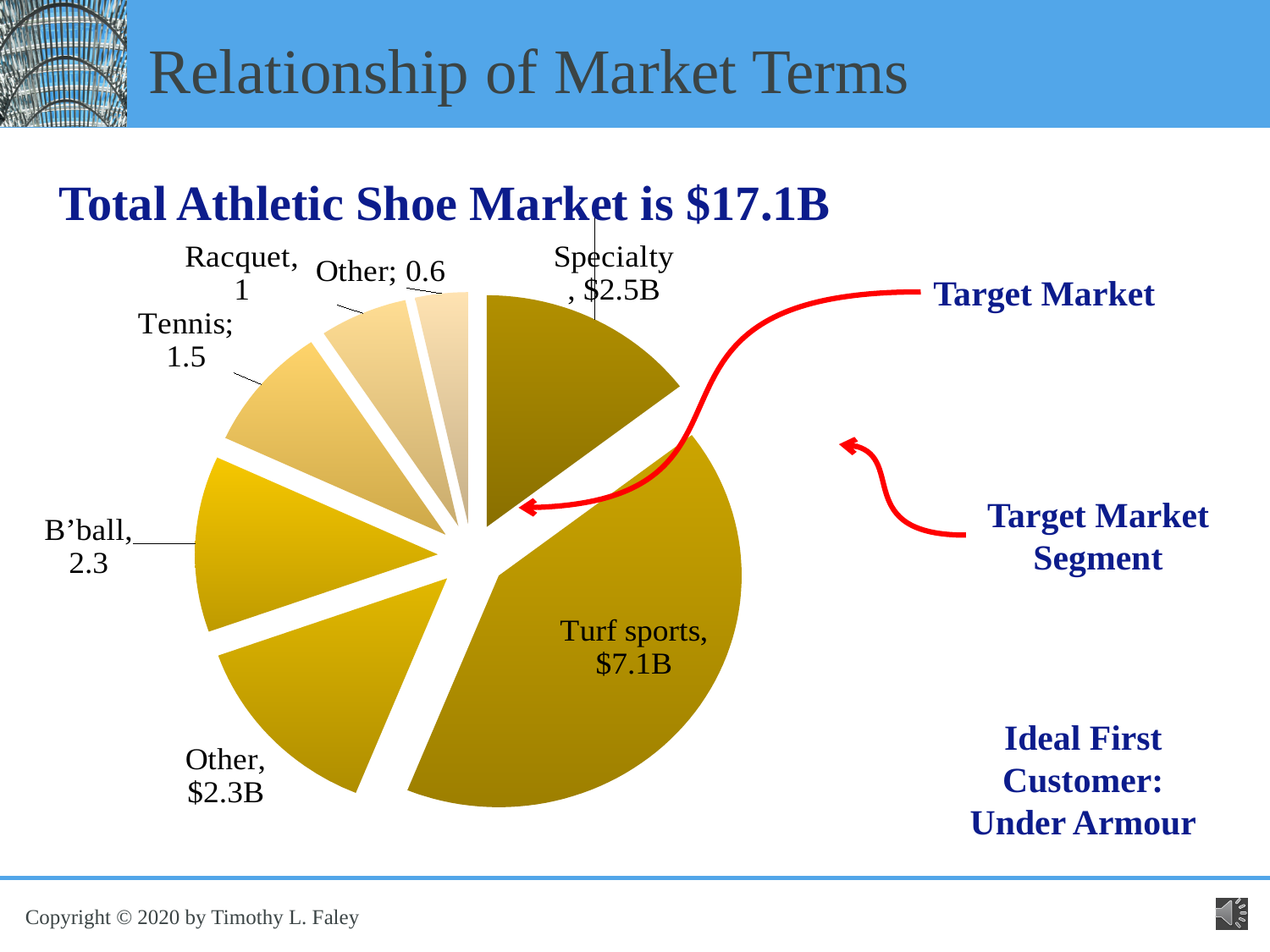
What kind of chart is shown on the slide? pie chart What is the value of the Racquet slice? 1 What is the value of the B'ball slice? 2.3 What is the title shown above the pie chart? Total Athletic Shoe Market is $17.1B Which is larger, the B'ball slice or the Tennis slice? B'ball What is the value of the Turf sports slice? $7.1B What is the difference between the Turf sports value and the Specialty value? $4.6B What is the value of the Tennis slice? 1.5 What is the value of the Specialty slice? $2.5B Which slice of the pie is the largest? Turf sports How many slices does the pie chart have? 7 Which slice of the pie is the smallest? Other (0.6)